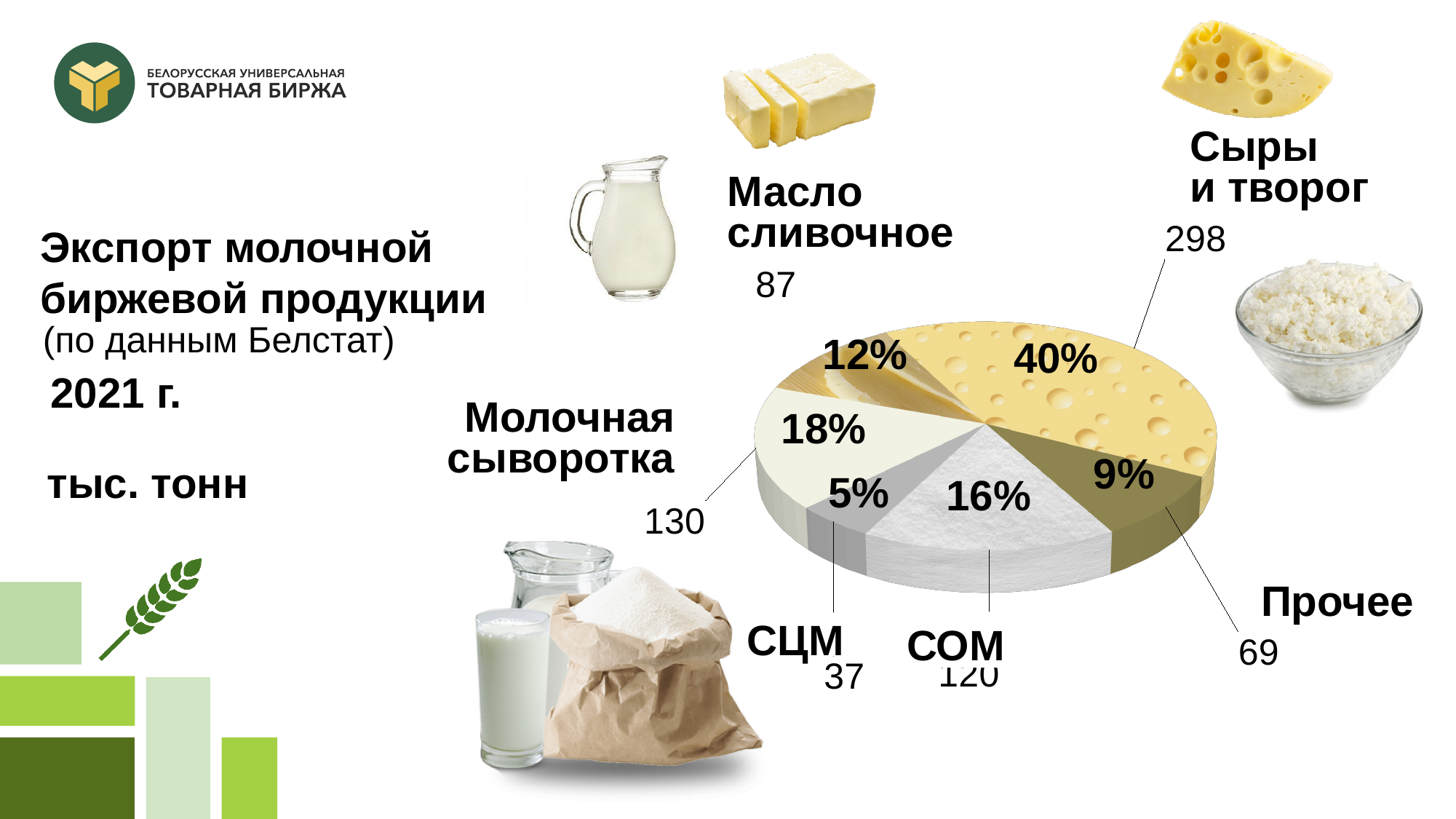
What is the value for Масло сливочное? 87 Which is larger, the value for Молочная сыворотка or the value for Прочее? Молочная сыворотка Which category has the largest share of the pie? Сыры и творог What is the value for Молочная сыворотка? 130 What share of the pie does СОМ account for? 16% What is the value for СЦМ? 37 What share of the pie does Сыры и творог account for? 40% What is the value for Сыры и творог? 298 Which category has the smallest share of the pie? СЦМ How many categories does the pie chart show? 6 What kind of chart is shown on the slide? pie chart What is the difference between the values for Сыры и творог and Молочная сыворотка? 168